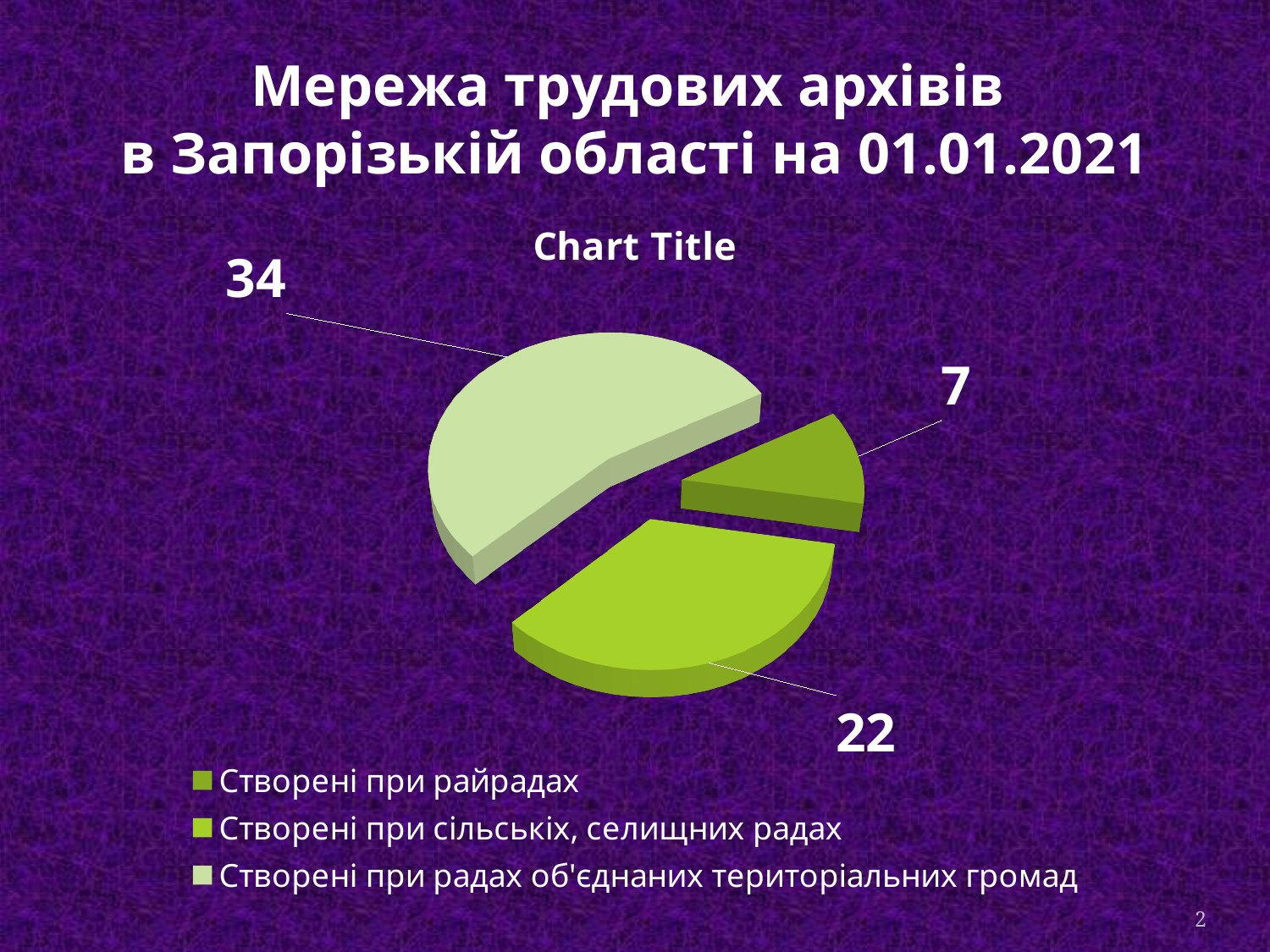
Which category has the smallest slice of the pie? Створені при райрадах What type of chart is shown on the slide? pie chart Which category has the largest slice of the pie? Створені при радах об'єднаних територіальних громад What is the difference between the values for "Створені при радах об'єднаних територіальних громад" and "Створені при сільських, селищних радах"? 12 What is the value for "Створені при радах об'єднаних територіальних громад"? 34 What is the total of all three slices in the pie chart? 63 How many slices does the pie chart have? 3 What is the title printed above the pie chart? Chart Title What is the value for "Створені при райрадах"? 7 Which is larger: the value for "Створені при сільських, селищних радах" or for "Створені при райрадах"? Створені при сільських, селищних радах How many entries does the legend list? 3 What is the value for "Створені при сільських, селищних радах"? 22